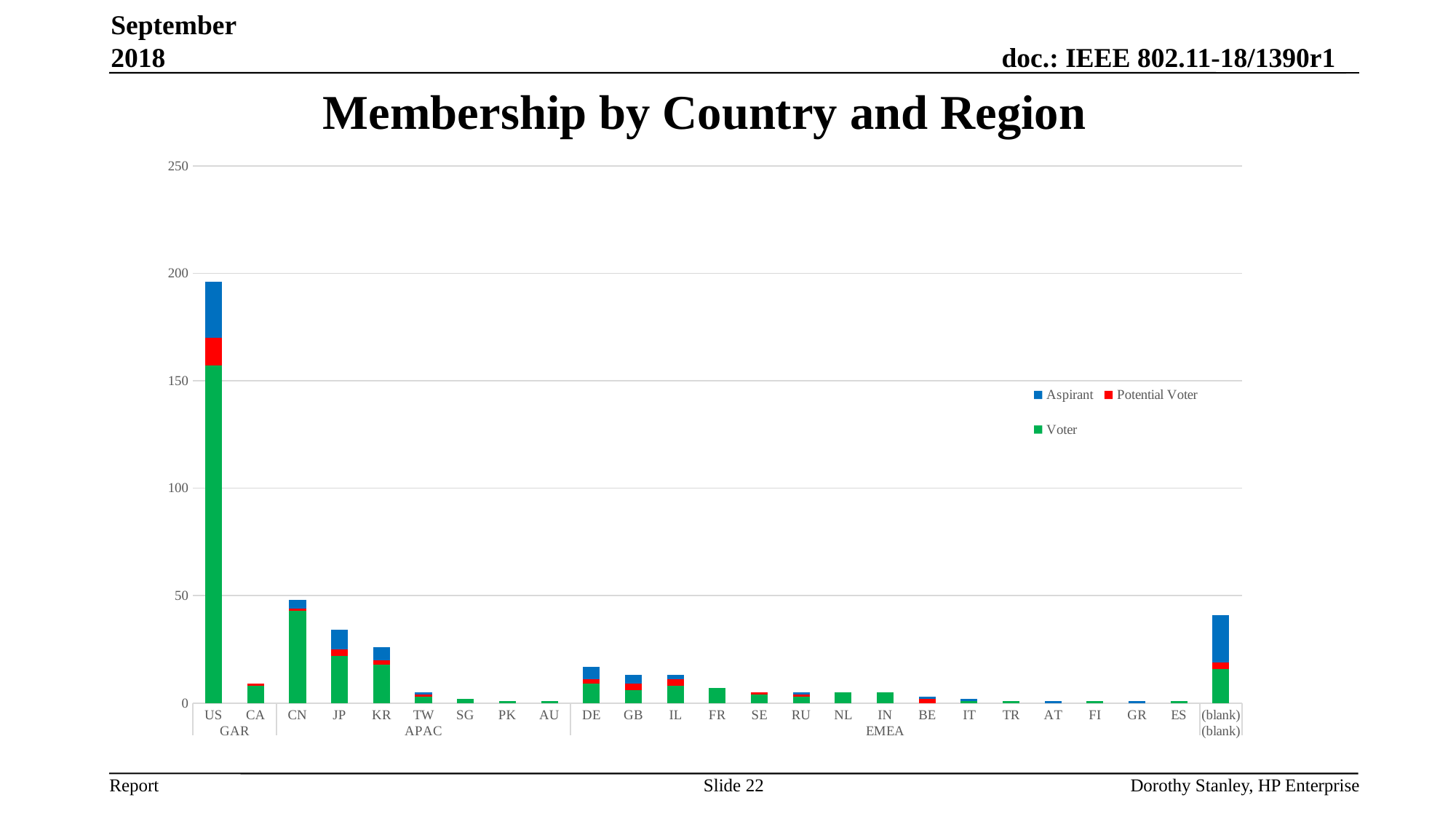
How many series does the legend list? 3 Which series is shown in green in the legend? Voter What is the title of the chart? Membership by Country and Region Which has a taller bar, JP or KR? JP Which has a taller bar, (blank) or CA? (blank) Is the total value for (blank) greater or less than 50? less Which has a taller bar, CN or JP? CN Which country has the tallest bar in the chart? US What kind of chart is shown on the slide? stacked bar chart Is the total value for US greater or less than 150? greater Is the total value for JP greater or less than 50? less